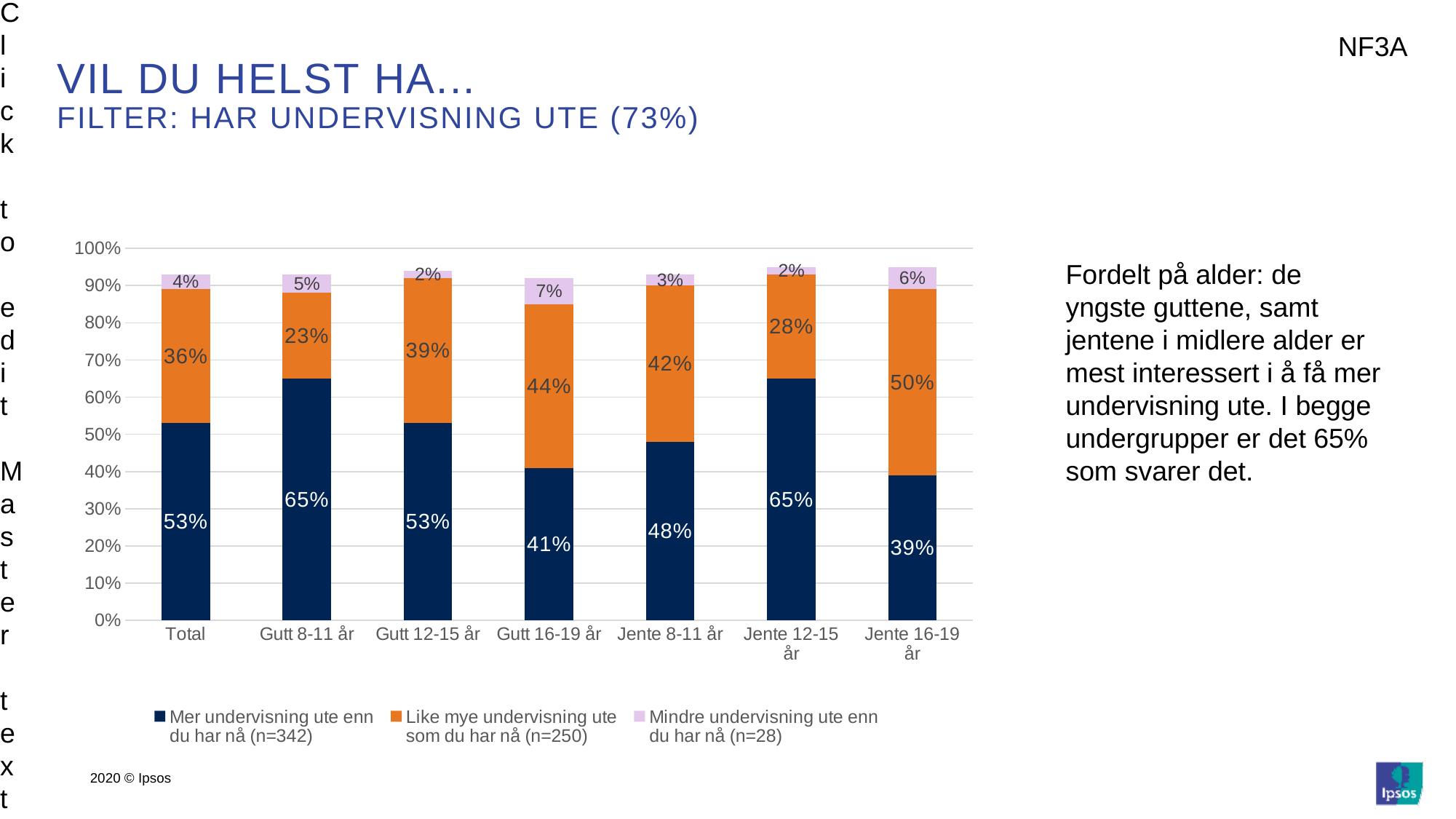
What is the value for 'Like mye undervisning ute som du har nå' for Jente 16-19 år? 50% What kind of chart is shown on the slide? Stacked bar chart Which category has the highest value for 'Like mye undervisning ute som du har nå'? Jente 16-19 år Which is larger: the 'Like mye undervisning ute som du har nå' value for Gutt 16-19 år or for Jente 8-11 år? Gutt 16-19 år How many series does the chart's legend list? 3 How many categories are shown on the x axis of the chart? 7 Which category has the lowest value for 'Mer undervisning ute enn du har nå'? Jente 16-19 år What is the value for 'Mindre undervisning ute enn du har nå' for Gutt 16-19 år? 7% What is the value for 'Mer undervisning ute enn du har nå' for Gutt 16-19 år? 41% What is the difference between the 'Mer undervisning ute enn du har nå' values for Gutt 8-11 år and Gutt 12-15 år? 12 percentage points What is the total of the stacked bar for Jente 12-15 år? 95% What is the sample size (n) given in the legend for 'Mindre undervisning ute enn du har nå'? n=28